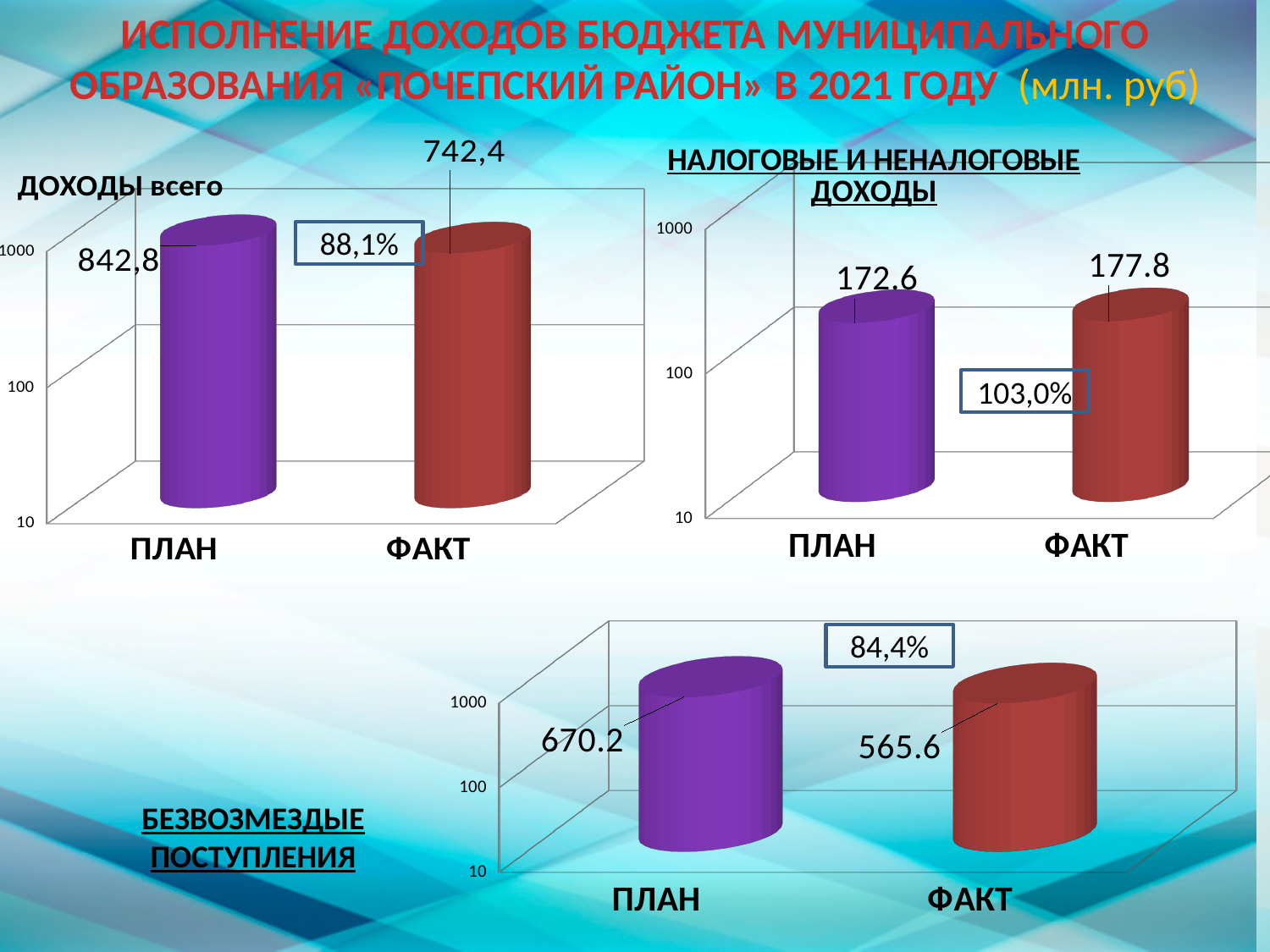
How many categories are shown on the x axis of the 'ДОХОДЫ всего' chart? 2 What kind of chart is the 'НАЛОГОВЫЕ И НЕНАЛОГОВЫЕ ДОХОДЫ' chart? Bar chart In the 'ДОХОДЫ всего' chart, what is the value for ФАКТ? 742,4 In the 'НАЛОГОВЫЕ И НЕНАЛОГОВЫЕ ДОХОДЫ' chart, which is larger, ПЛАН or ФАКТ? ФАКТ What percentage is shown in the box on the 'НАЛОГОВЫЕ И НЕНАЛОГОВЫЕ ДОХОДЫ' chart? 103,0% In the 'БЕЗВОЗМЕЗДНЫЕ ПОСТУПЛЕНИЯ' chart, which category has the lowest value? ФАКТ In the 'ДОХОДЫ всего' chart, what is the value for ПЛАН? 842,8 In the 'НАЛОГОВЫЕ И НЕНАЛОГОВЫЕ ДОХОДЫ' chart, what is the value for ФАКТ? 177.8 In the 'БЕЗВОЗМЕЗДНЫЕ ПОСТУПЛЕНИЯ' chart, what is the difference between the ПЛАН and ФАКТ values? 104.6 In the 'БЕЗВОЗМЕЗДНЫЕ ПОСТУПЛЕНИЯ' chart, what is the value for ПЛАН? 670.2 What percentage is shown in the box on the 'БЕЗВОЗМЕЗДНЫЕ ПОСТУПЛЕНИЯ' chart? 84,4% In the 'ДОХОДЫ всего' chart, what is the difference between the ПЛАН and ФАКТ values? 100,4